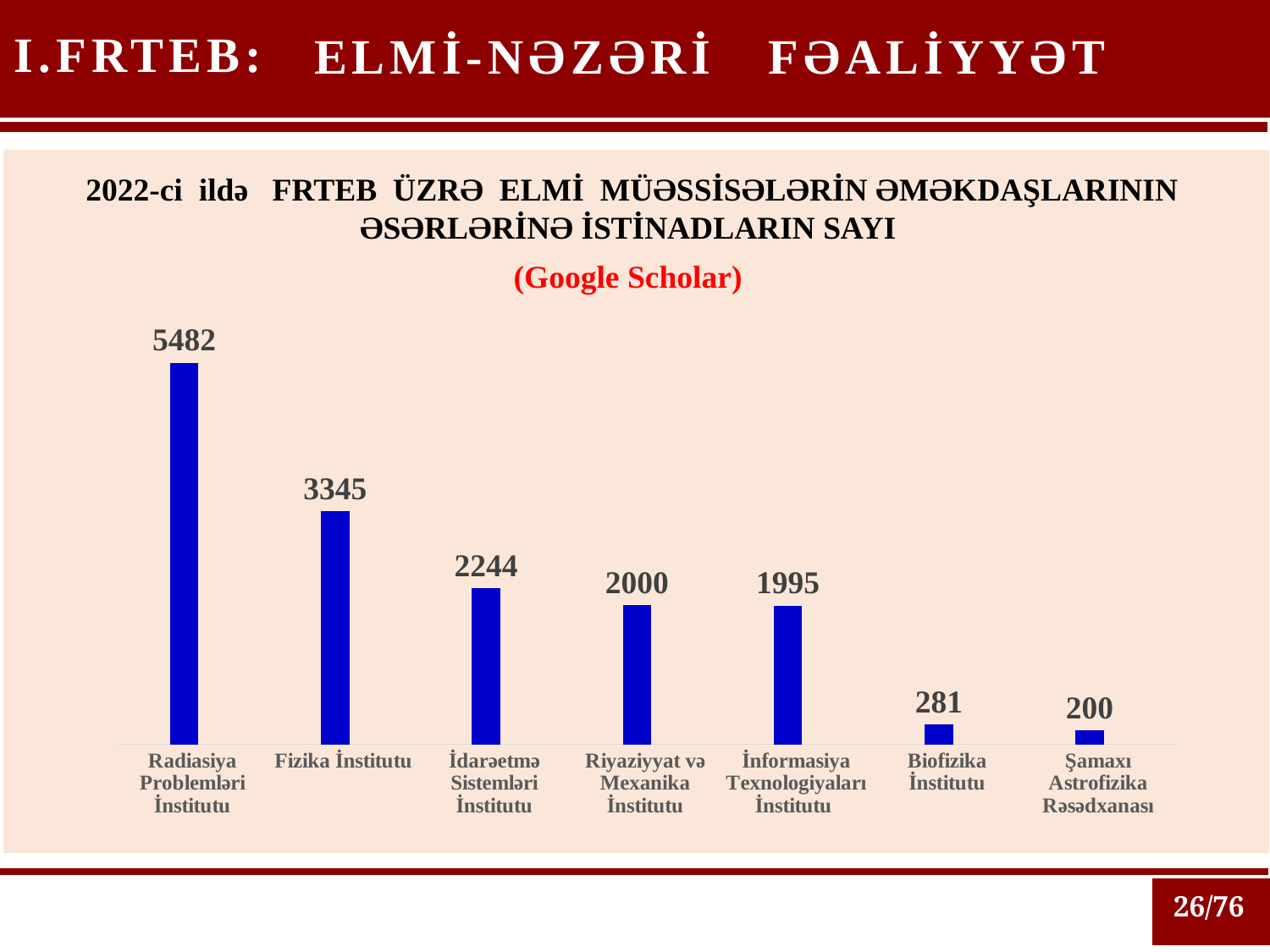
What is the value for Fizika İnstitutu? 3345 What is the difference between the values for Radiasiya Problemləri İnstitutu and Fizika İnstitutu? 2137 What is the value for Şamaxı Astrofizika Rəsədxanası? 200 What is the value for Radiasiya Problemləri İnstitutu? 5482 What kind of chart is shown on the slide? Bar chart What is the difference between the values for Riyaziyyat və Mexanika İnstitutu and İnformasiya Texnologiyaları İnstitutu? 5 Which is larger, the value for İdarəetmə Sistemləri İnstitutu or the value for Biofizika İnstitutu? İdarəetmə Sistemləri İnstitutu What is the value for Biofizika İnstitutu? 281 Which source is named in parentheses under the chart title? Google Scholar Which institution has the lowest number of citations? Şamaxı Astrofizika Rəsədxanası How many institutions are shown in the chart? 7 Which institution has the highest number of citations? Radiasiya Problemləri İnstitutu